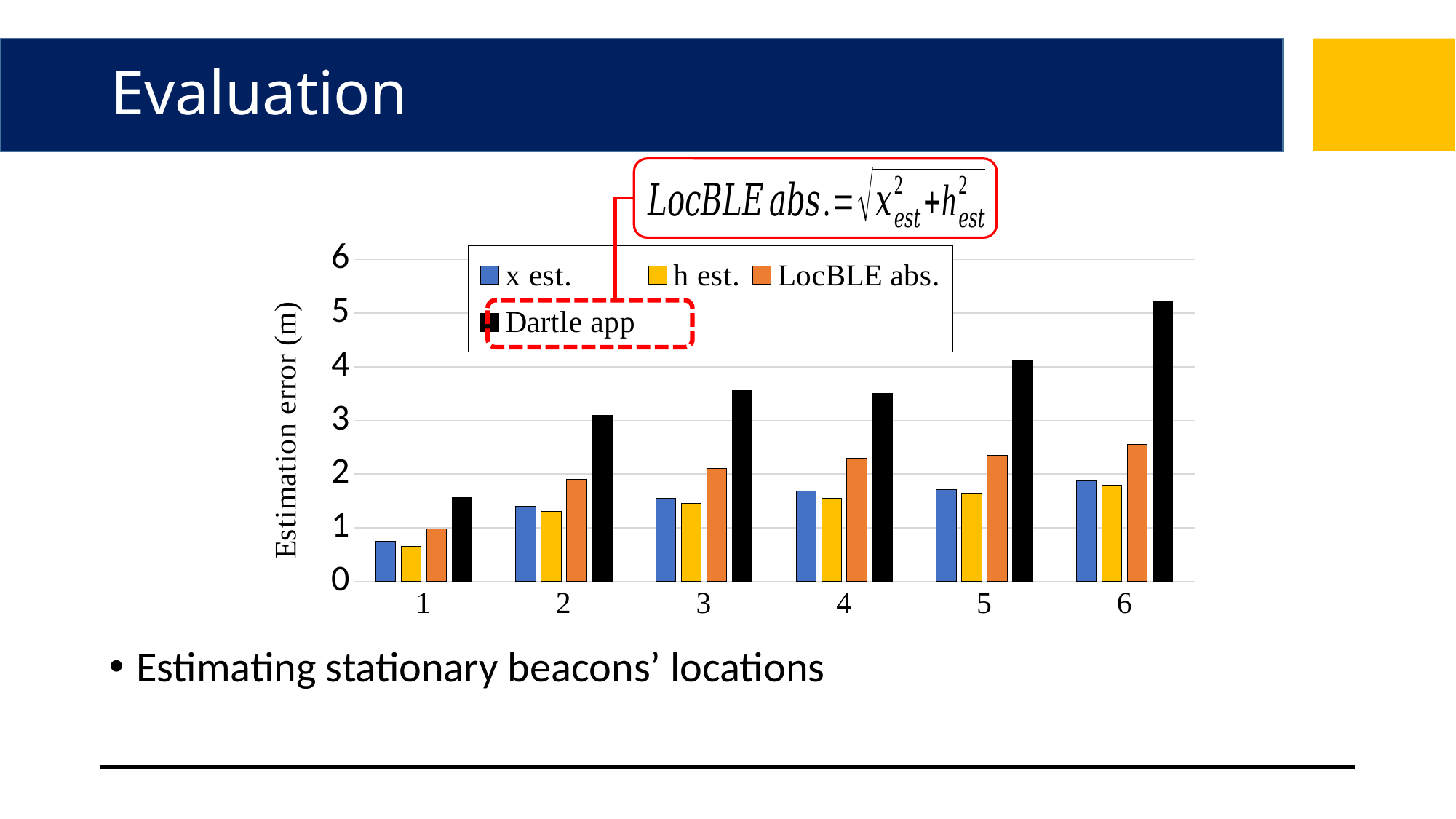
How many series does the legend list? 4 For which category is the Dartle app estimation error highest? 6 Do the LocBLE abs. values rise or fall from category 1 to category 6? rise What kind of chart is shown on the slide? bar chart How many categories are shown on the x axis? 6 For category 6, which is larger: Dartle app or LocBLE abs.? Dartle app What is the label of the y axis? Estimation error (m) Is the h est. value for category 1 greater or less than 1? less Is the LocBLE abs. value for category 6 greater or less than 2? greater Is the Dartle app value for category 3 greater or less than 3? greater For which category is the Dartle app estimation error lowest? 1